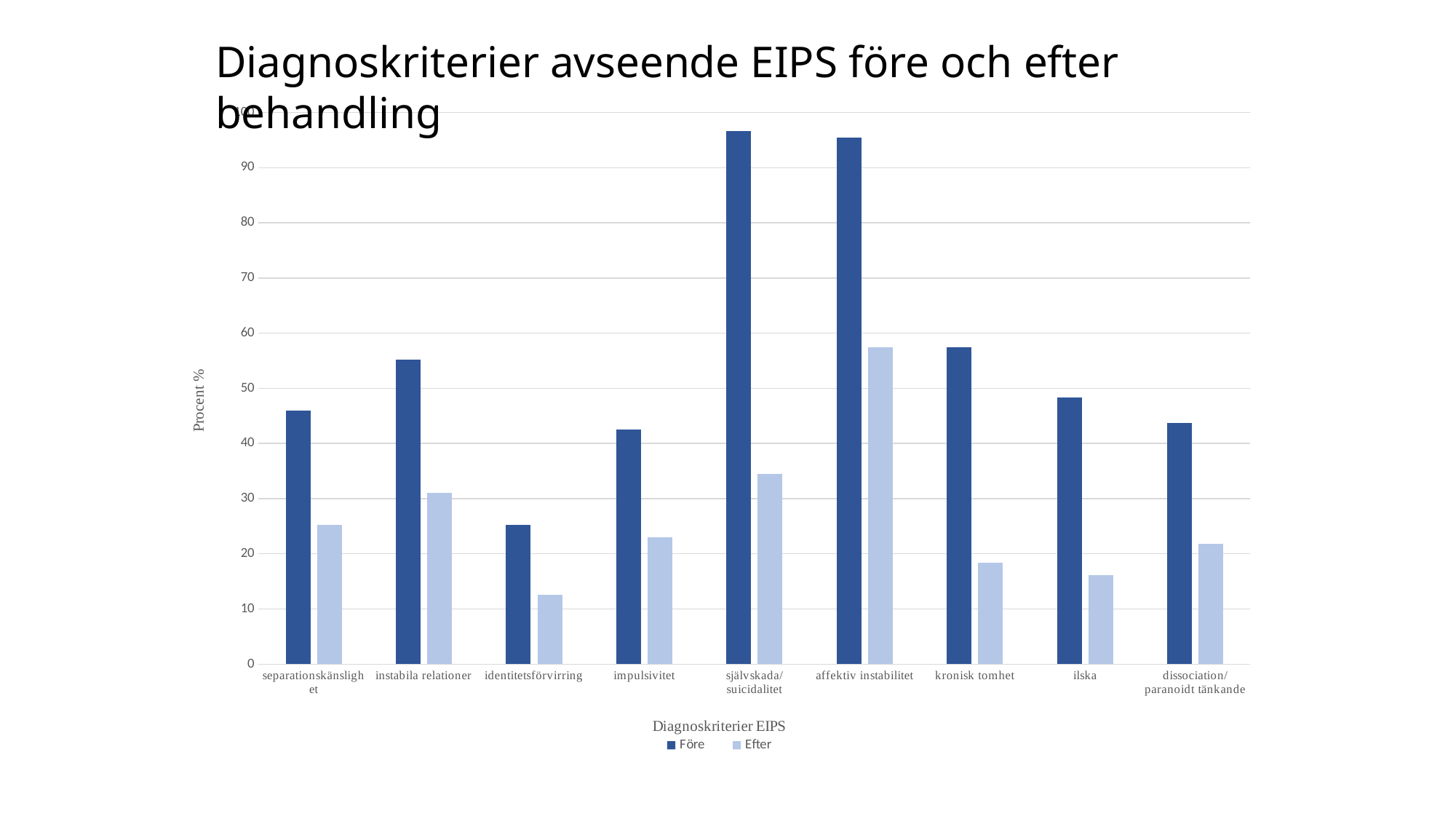
How many diagnostic criteria (categories) are shown on the x axis? 9 Which is larger for the Före series: instabila relationer or ilska? instabila relationer Is the Före value for separationskänslighet greater or less than 40? greater Which category has the lowest value for the Före series? identitetsförvirring What kind of chart is shown on the slide? bar chart What is the label of the y axis? Procent % Is the Efter value for självskada/suicidalitet greater or less than 40? less How many series does the legend list? 2 Is the Efter value for ilska greater or less than 20? less Which category has the lowest value for the Efter series? identitetsförvirring Which category has the highest value for the Efter series? affektiv instabilitet